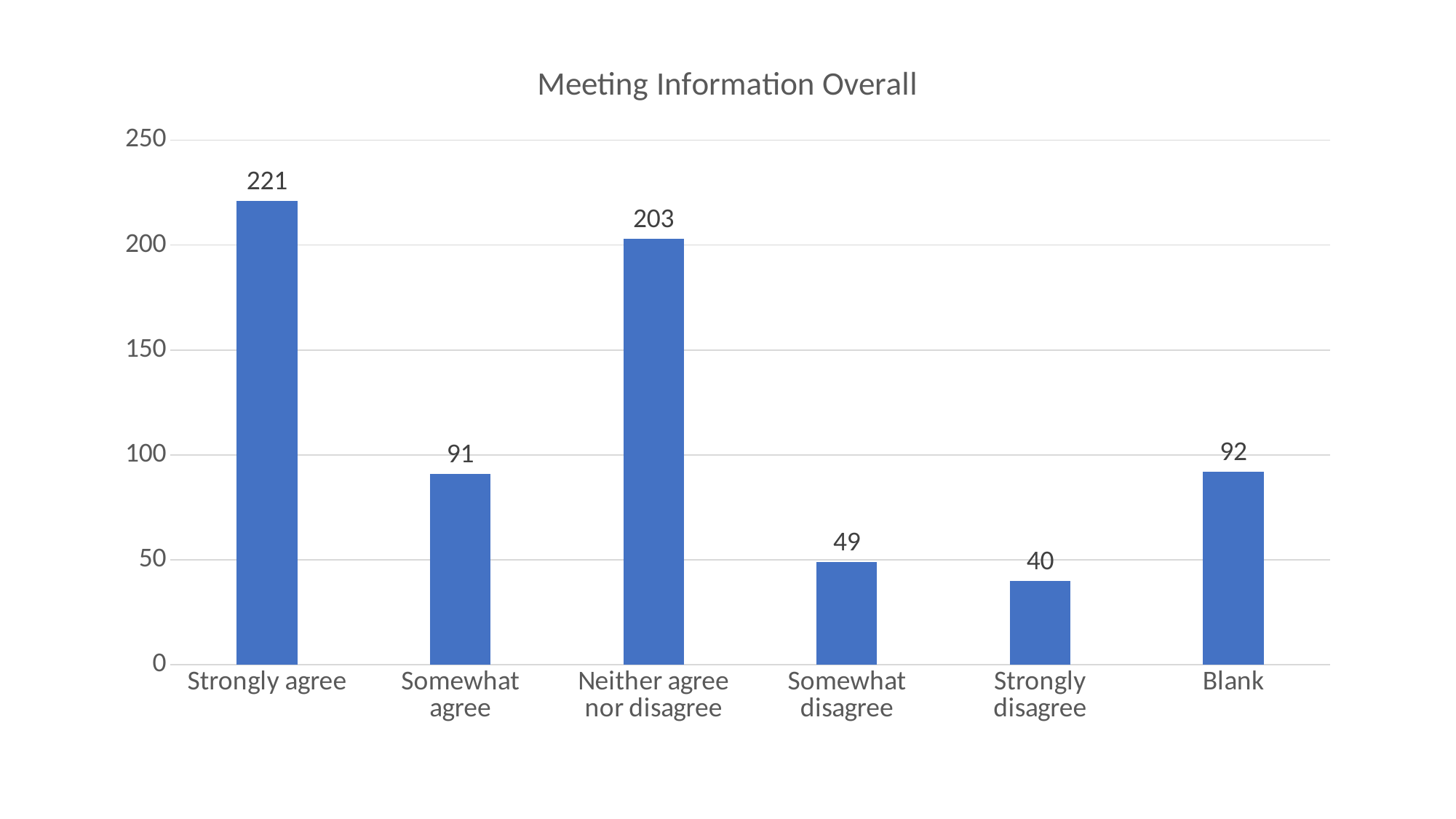
Which category has the highest value? Strongly agree What is the value for Strongly agree? 221 How many categories are shown on the x axis? 6 Is the value for Neither agree nor disagree greater or less than 200? greater Which category has the lowest value? Strongly disagree What is the difference between the values for Somewhat disagree and Strongly disagree? 9 What is the title of the chart? Meeting Information Overall What is the value for Strongly disagree? 40 What is the value for Blank? 92 What is the difference between the values for Strongly agree and Neither agree nor disagree? 18 Which is larger, the value for Somewhat agree or the value for Somewhat disagree? Somewhat agree What is the value for Neither agree nor disagree? 203